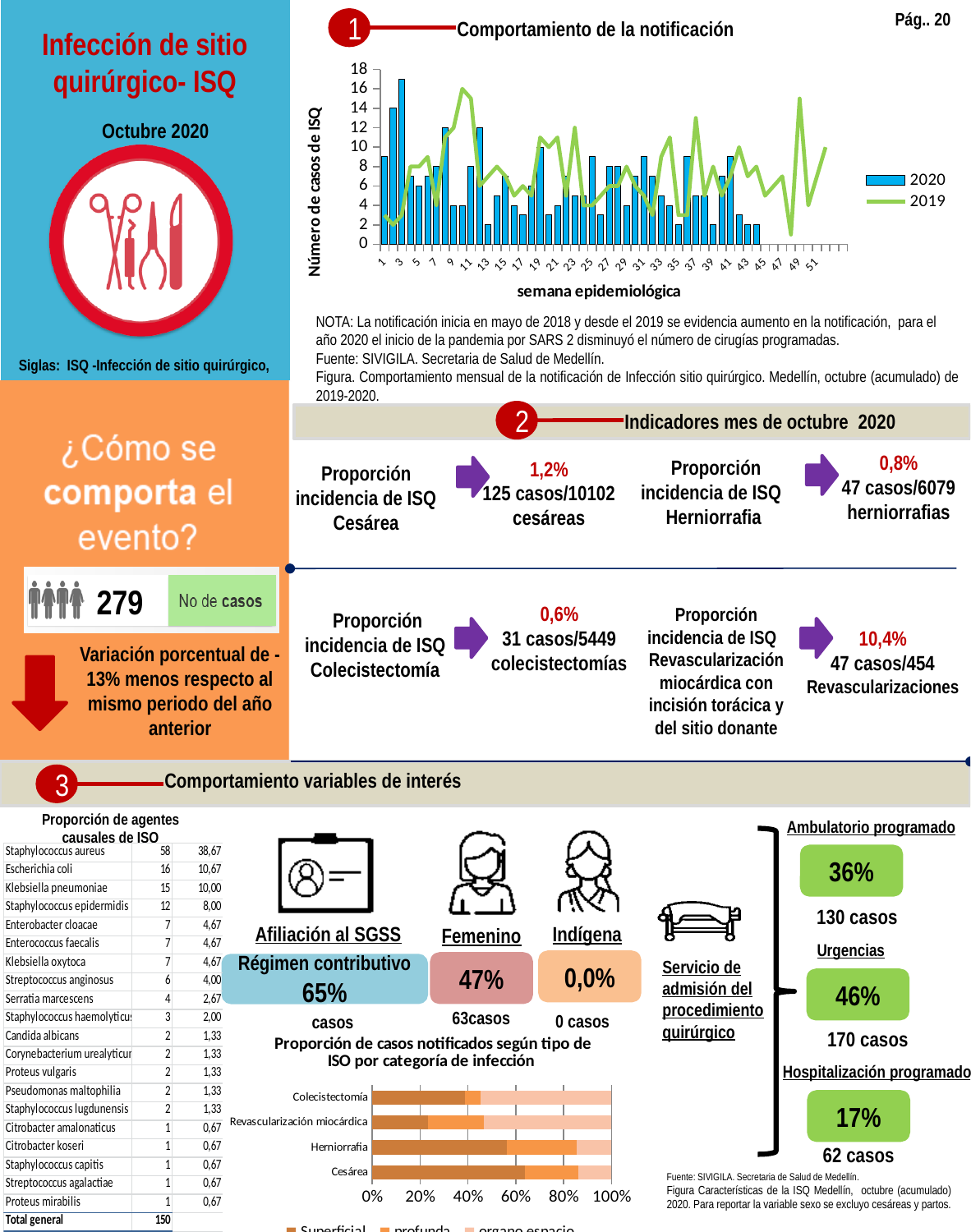
In the chart 'Comportamiento de la notificación', what is the label of the x axis? semana epidemiológica In the chart 'Comportamiento de la notificación', which epidemiological week has the highest 2020 bar? 3 In the chart 'Comportamiento de la notificación', is the 2020 value for week 3 greater or less than 14? greater In the chart 'Comportamiento de la notificación', is the 2020 value for week 44 greater or less than 4? less What kind of chart is 'Proporción de casos notificados según tipo de ISO por categoría de infección'? stacked bar chart In the chart 'Comportamiento de la notificación', how many series does the legend list? 2 In the chart 'Comportamiento de la notificación', which year is plotted as a line rather than bars? 2019 In the chart 'Comportamiento de la notificación', is the 2020 value for week 2 greater or less than 10? greater How many series does the legend list in the chart 'Proporción de casos notificados según tipo de ISO por categoría de infección'? 3 In the chart 'Comportamiento de la notificación', which is larger, the 2020 bar for week 3 or the 2020 bar for week 20? week 3 How many categories are shown in the chart 'Proporción de casos notificados según tipo de ISO por categoría de infección'? 4